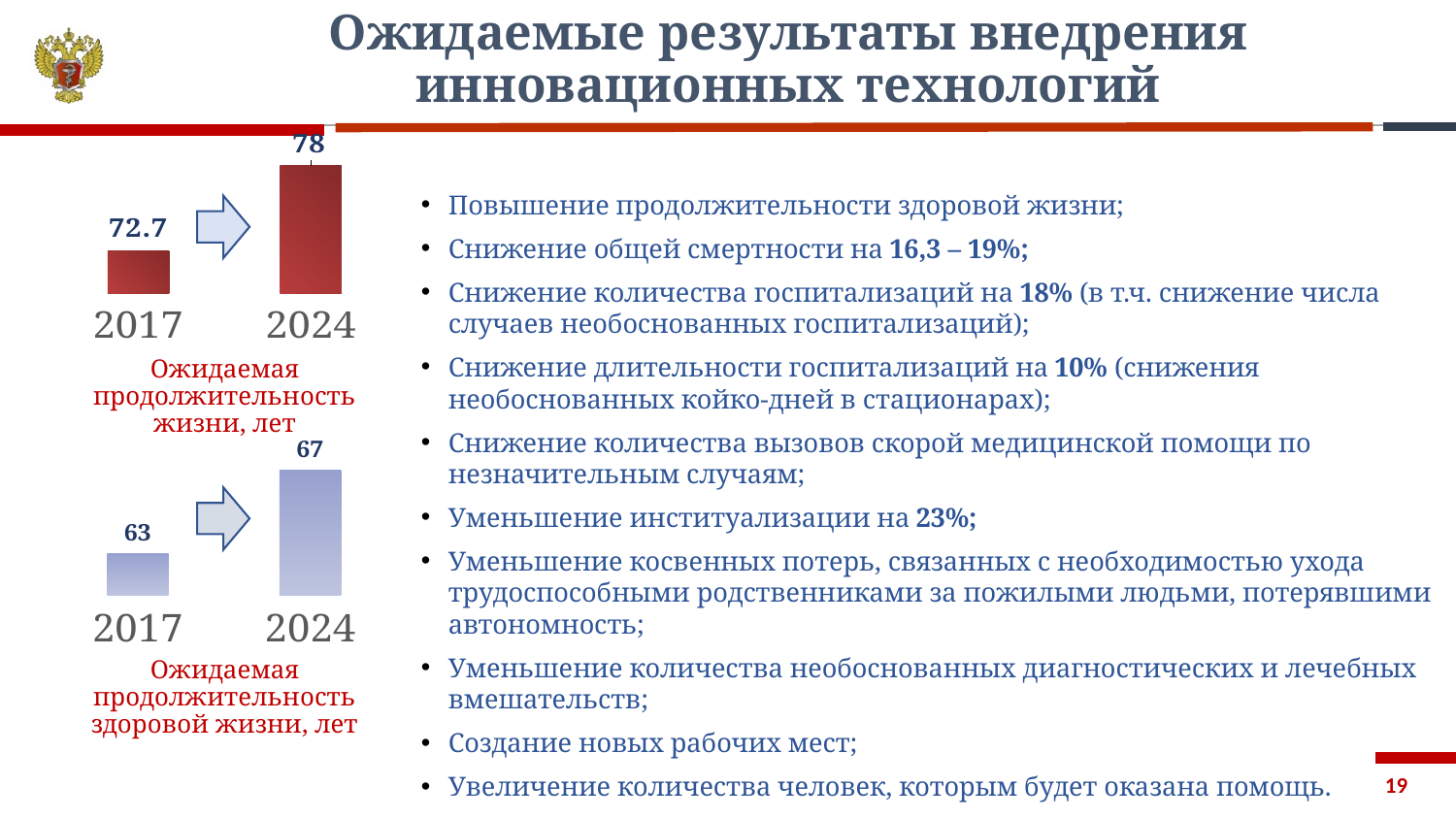
In the bottom chart (Ожидаемая продолжительность здоровой жизни, лет), which year has the lower value? 2017 In the bottom chart (Ожидаемая продолжительность здоровой жизни, лет), what is the value for 2024? 67 In the bottom chart (Ожидаемая продолжительность здоровой жизни, лет), what is the value for 2017? 63 In the top chart (Ожидаемая продолжительность жизни, лет), do the values rise or fall from 2017 to 2024? rise In the top chart (Ожидаемая продолжительность жизни, лет), which year has the higher value? 2024 What type of chart is used for Ожидаемая продолжительность здоровой жизни, лет? bar chart In the top chart (Ожидаемая продолжительность жизни, лет), what is the value for 2024? 78 In the bottom chart (Ожидаемая продолжительность здоровой жизни, лет), is the value for 2024 larger or smaller than the value for 2017? larger In the bottom chart (Ожидаемая продолжительность здоровой жизни, лет), what is the difference between the 2024 and 2017 values? 4 In the top chart (Ожидаемая продолжительность жизни, лет), what is the value for 2017? 72.7 How many bars does the top chart (Ожидаемая продолжительность жизни, лет) contain? 2 In the top chart (Ожидаемая продолжительность жизни, лет), by how much does the value for 2024 exceed the value for 2017? 5.3